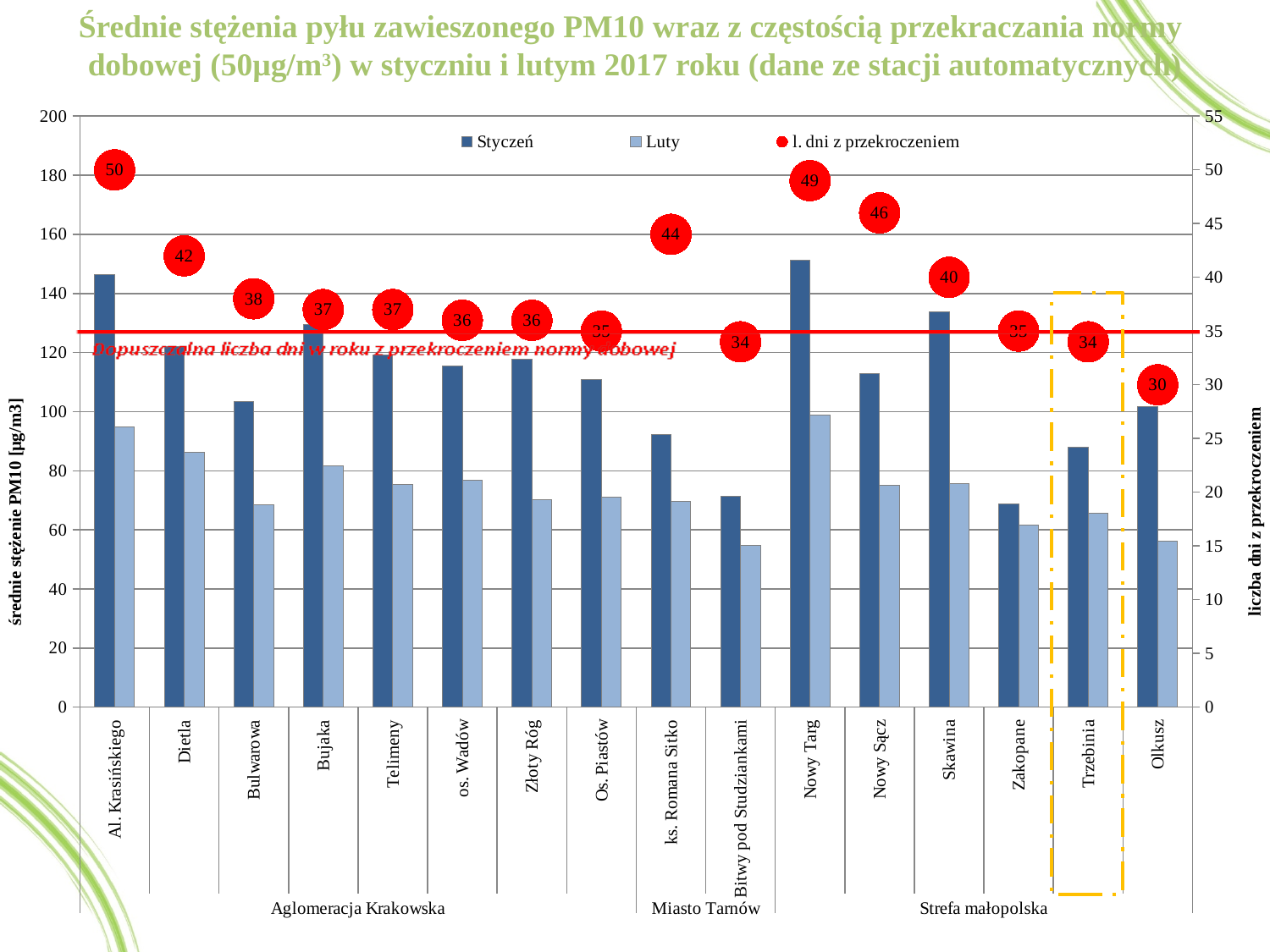
How many days with exceedance are shown for Olkusz? 30 How many stations are shown on the x axis? 16 Which has more days with exceedance, Nowy Sącz or Skawina? Nowy Sącz How many days with exceedance (l. dni z przekroczeniem) are shown for Al. Krasińskiego? 50 How many days with exceedance are shown for Nowy Targ? 49 Which station has the highest number of days with exceedance? Al. Krasińskiego Which station has the lowest number of days with exceedance? Olkusz Is the Luty value for Al. Krasińskiego greater or less than 80? greater How many series does the legend list? 3 Is the Styczeń value for Zakopane greater or less than 80? less What is the difference in days with exceedance between Al. Krasińskiego and Olkusz? 20 Is the Styczeń value for Nowy Targ greater or less than 140? greater